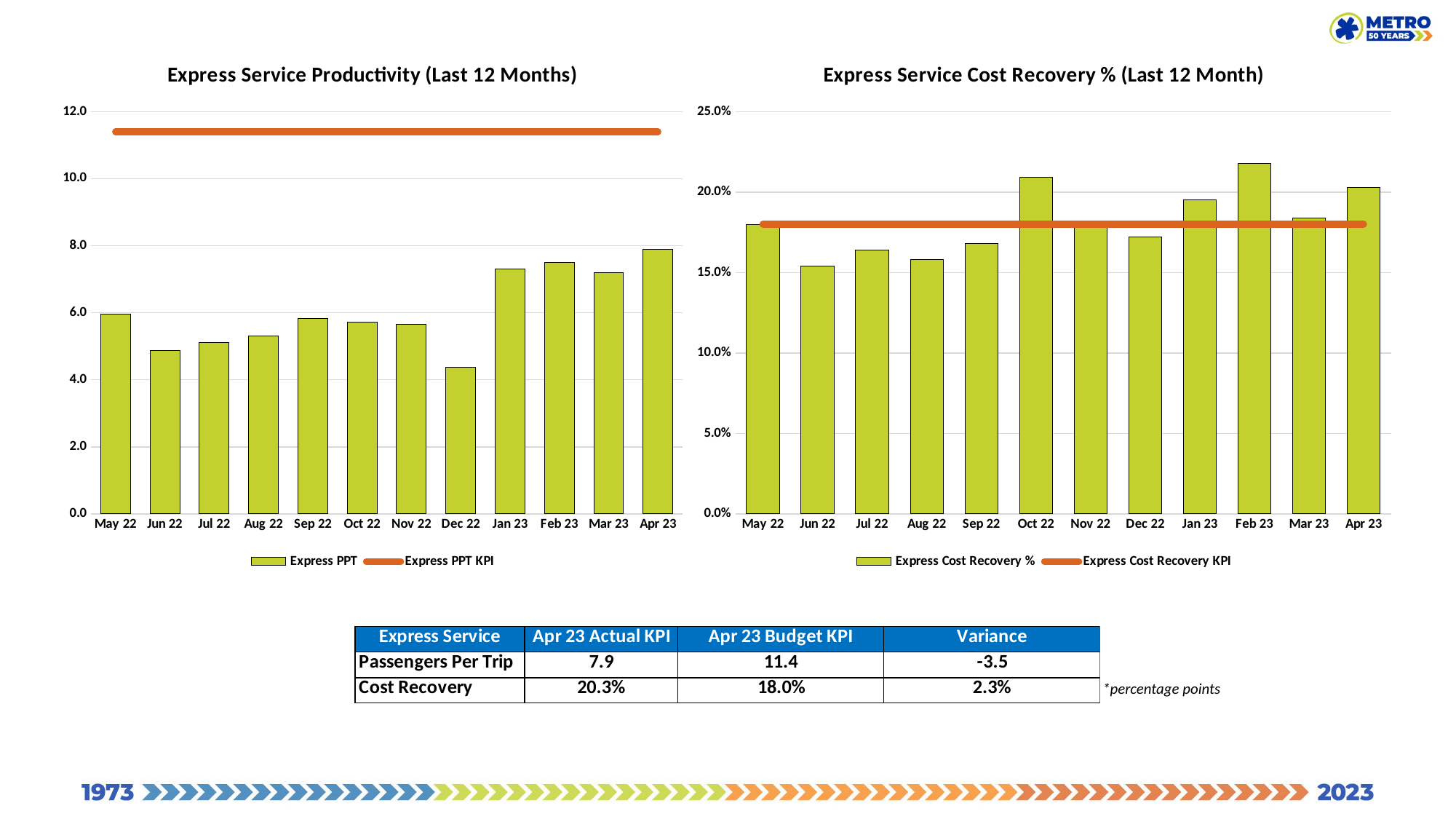
In the Express Service Cost Recovery % (Last 12 Month) chart, which month has the highest Express Cost Recovery % bar? Feb 23 What colour is the Express PPT KPI line in the Express Service Productivity (Last 12 Months) chart? orange According to the slide, what is the Apr 23 Express Cost Recovery % value? 20.3% In the Express Service Cost Recovery % (Last 12 Month) chart, is the value for Oct 22 greater or less than 20.0%? greater In the Express Service Cost Recovery % (Last 12 Month) chart, is the value for Jun 22 greater or less than 20.0%? less In the Express Service Productivity (Last 12 Months) chart, which is larger, the Express PPT bar for Sep 22 or for Jun 22? Sep 22 What kind of chart is the Express Service Productivity (Last 12 Months) chart? bar chart How many months are plotted on the x axis of the Express Service Productivity (Last 12 Months) chart? 12 How many series does the legend of the Express Service Cost Recovery % (Last 12 Month) chart list? 2 In the Express Service Productivity (Last 12 Months) chart, is the Express PPT value for Jan 23 greater or less than 6.0? greater In the Express Service Productivity (Last 12 Months) chart, which month has the lowest Express PPT bar? Dec 22 In the Express Service Productivity (Last 12 Months) chart, which month has the highest Express PPT bar? Apr 23